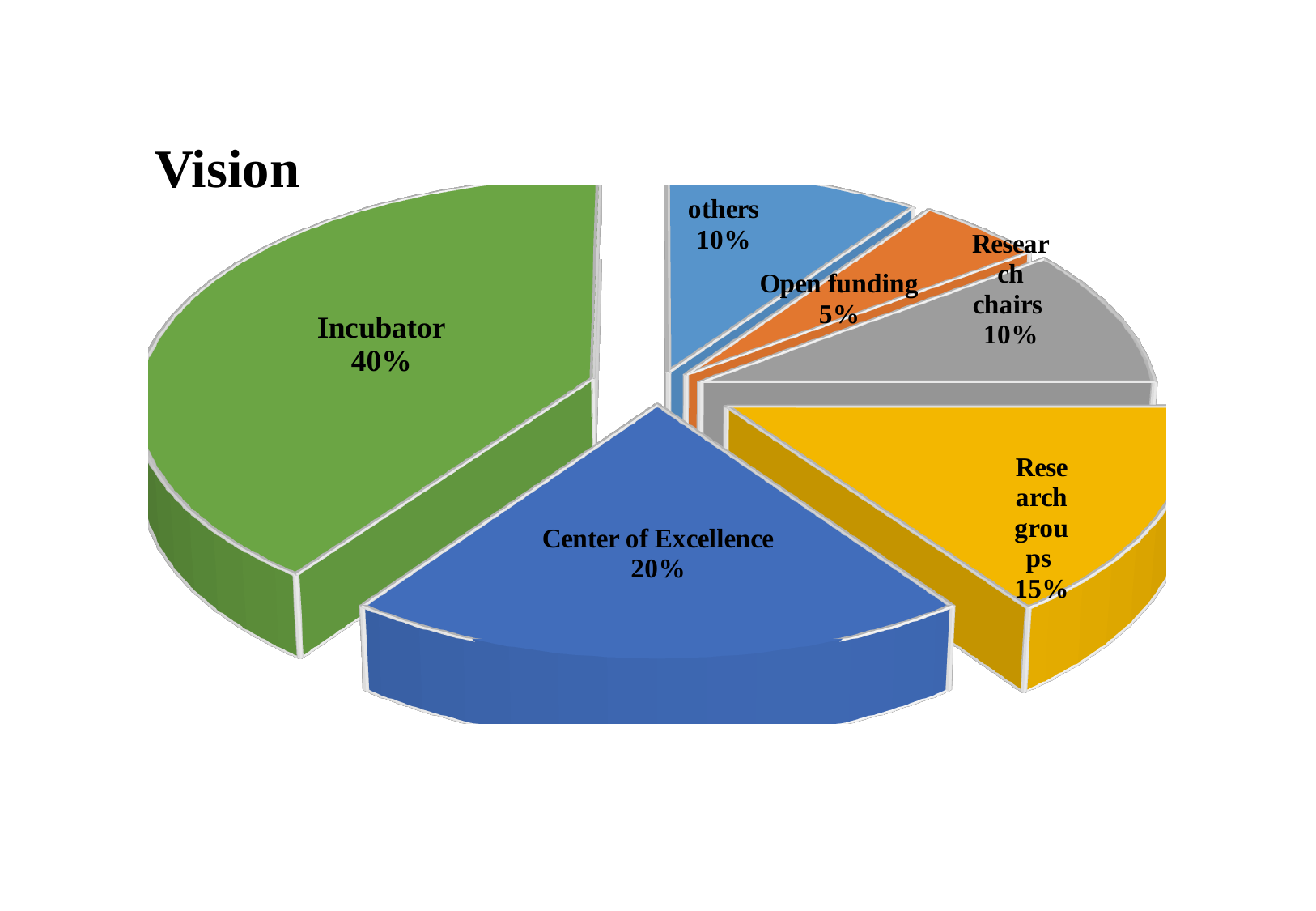
What is the value for Open funding? 5% What is the value for Incubator? 40% Which category has the smallest share of the pie? Open funding What is the value for Center of Excellence? 20% What is the value for Research groups? 15% Which category has the largest share of the pie? Incubator What kind of chart is shown on the slide? Pie chart What is the value for Research chairs? 10% Which is larger, Research groups or others? Research groups How many slices does the pie chart have? 6 What is the difference between the Incubator and Center of Excellence shares? 20% What is the title of the slide? Vision